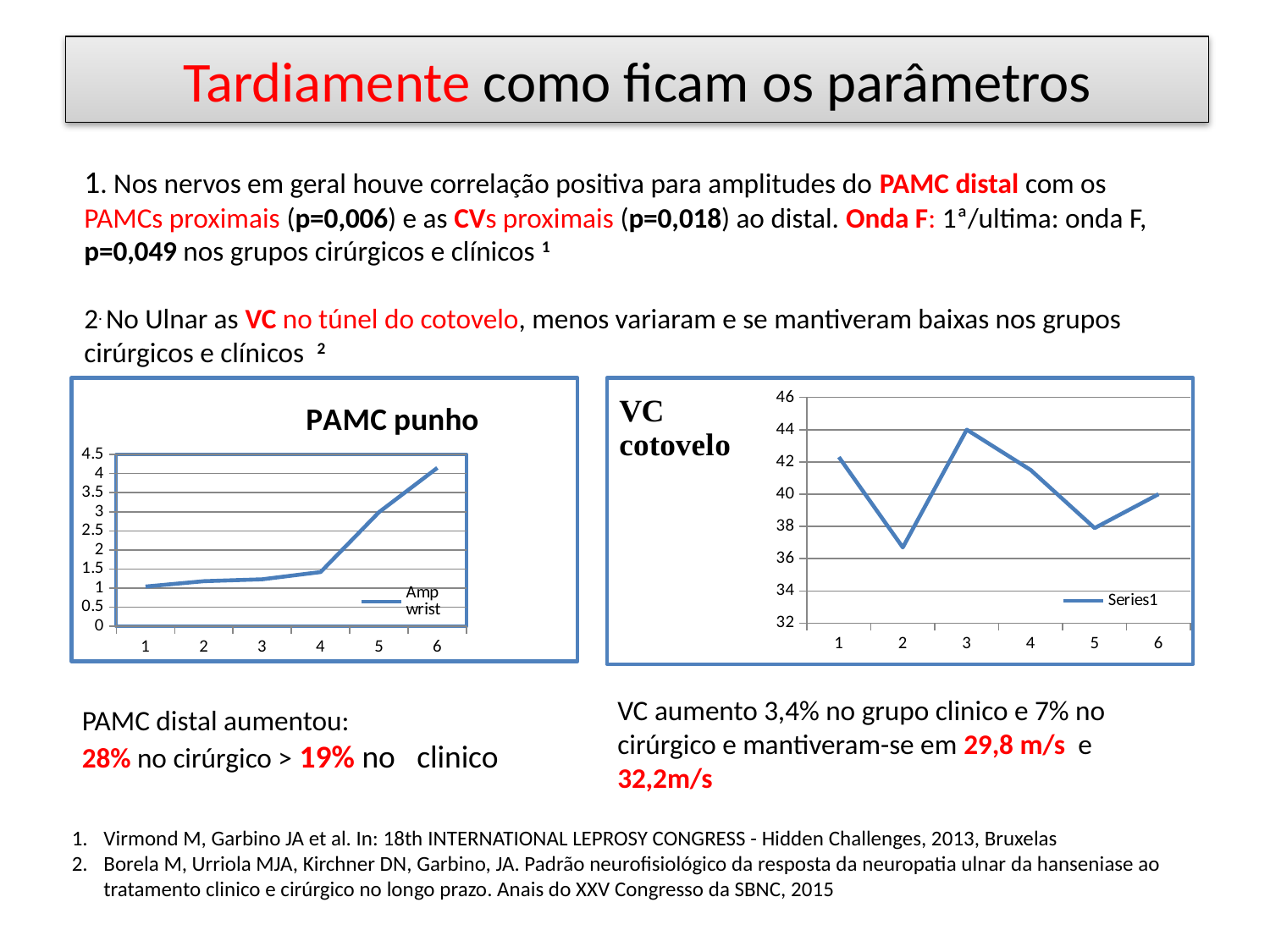
In the 'PAMC punho' chart, do the values generally rise or fall from point 1 to point 6? rise In the 'PAMC punho' chart, is the value at point 5 greater or less than 2.5? greater What kind of chart is the 'VC cotovelo' chart on the right? line chart In the 'VC cotovelo' chart, is the value at point 2 greater or less than 38? less In the 'VC cotovelo' chart, how many series does the legend list? 1 In the 'PAMC punho' chart, how many points are plotted along the x axis? 6 What kind of chart is the 'PAMC punho' chart on the left? line chart In the 'PAMC punho' chart, what is the name of the series shown in the legend? Amp wrist In the 'VC cotovelo' chart, at which x-axis point is the value highest? 3 In the 'VC cotovelo' chart, at which x-axis point is the value lowest? 2 In the 'VC cotovelo' chart, what is the name of the series shown in the legend? Series1 In the 'PAMC punho' chart, at which x-axis point is the value highest? 6